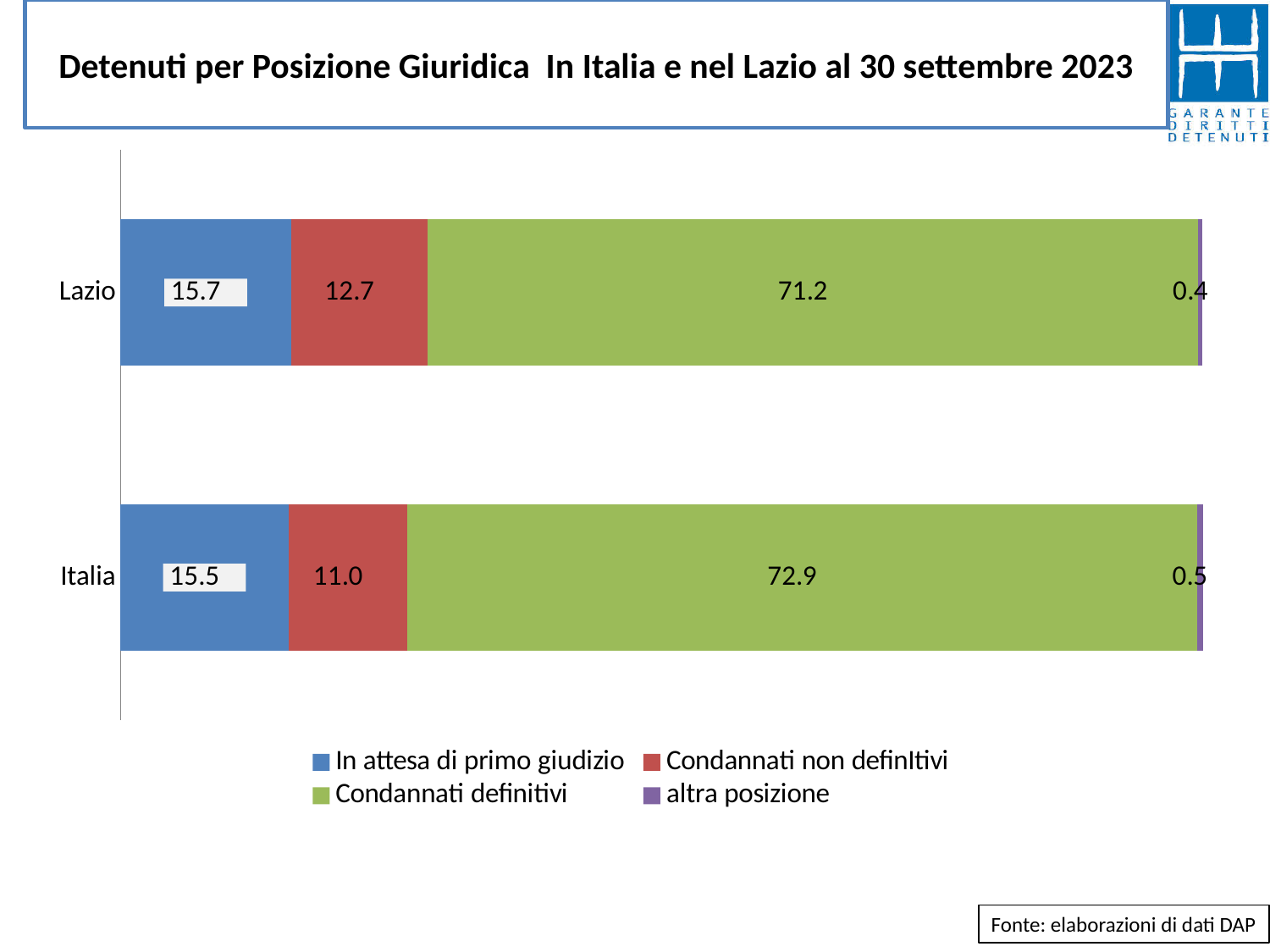
What is the value for 'altra posizione' in the Italia bar? 0.5 What is the difference between the 'Condannati non definItivi' values for Lazio and Italia? 1.7 What is the value for 'Condannati non definItivi' in the Lazio bar? 12.7 Which series has the largest value in the Italia bar? Condannati definitivi Which has the larger 'Condannati definitivi' value, Lazio or Italia? Italia What kind of chart is shown on the slide? Stacked bar chart How many categories (bars) are shown in the chart? 2 What is the title of the chart? Detenuti per Posizione Giuridica In Italia e nel Lazio al 30 settembre 2023 How many series does the legend list? 4 Which series has the smallest value in the Lazio bar? altra posizione What is the value for 'Condannati definitivi' in the Lazio bar? 71.2 What is the value for 'In attesa di primo giudizio' in the Italia bar? 15.5